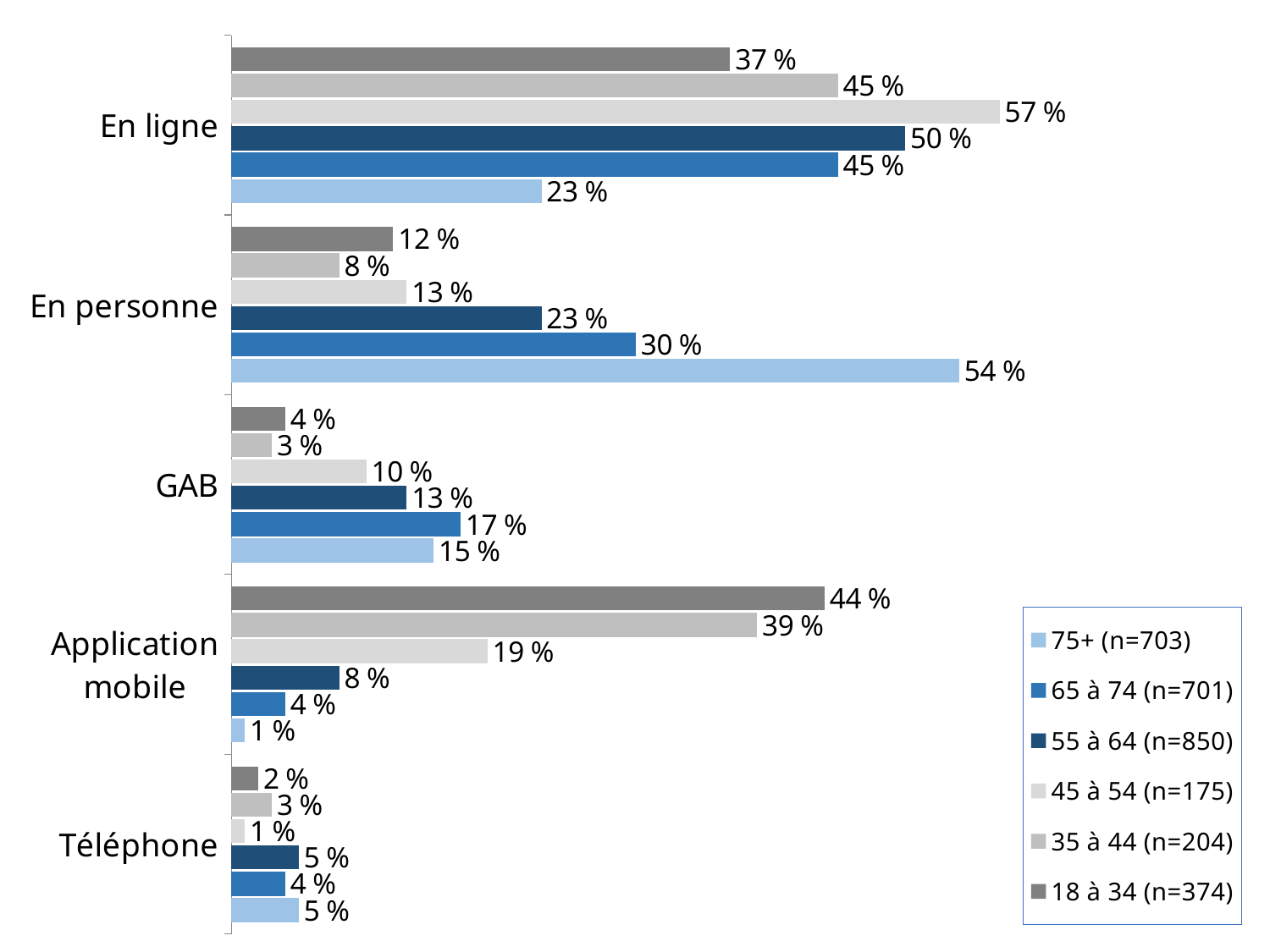
What is the value for the 18 à 34 (n=374) group for Application mobile? 44 % Which age group has the lowest value for Application mobile? 75+ (n=703) How many categories are shown on the vertical axis? 5 Which is larger for GAB: the value for 65 à 74 (n=701) or the value for 75+ (n=703)? 65 à 74 (n=701) Which legend entry has the largest sample size (n)? 55 à 64 (n=850) What is the difference between the 75+ (n=703) and 18 à 34 (n=374) values for En personne? 42 % What is the value for the 45 à 54 (n=175) group for En ligne? 57 % What is the value for the 65 à 74 (n=701) group for GAB? 17 % Which age group has the highest value for En ligne? 45 à 54 (n=175) How many series does the legend list? 6 What is the value for the 75+ (n=703) group for En personne? 54 % What kind of chart is this? Bar chart